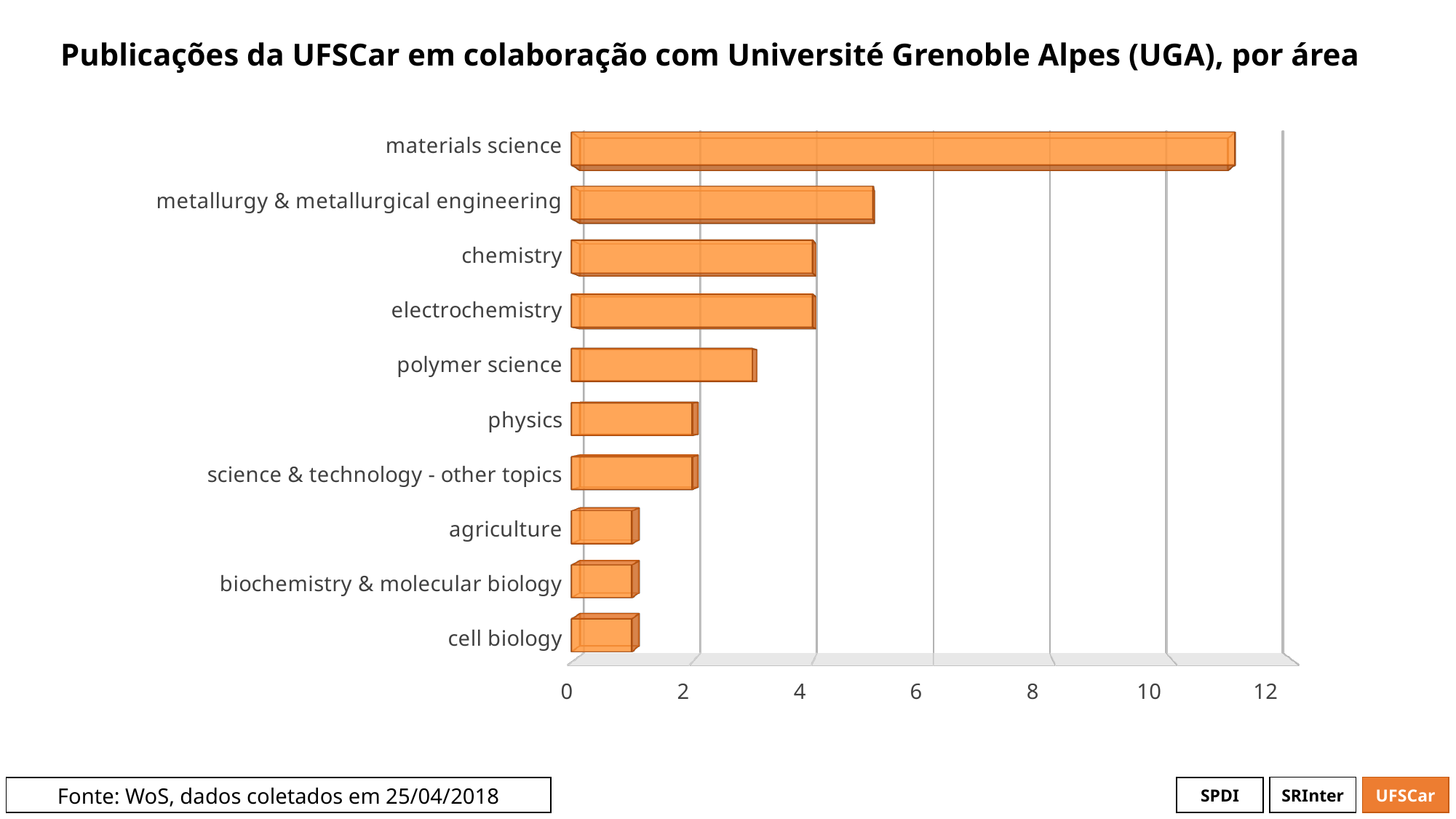
Is the value for metallurgy & metallurgical engineering greater or less than 6? less Which has more publications, chemistry or cell biology? chemistry Which area has the highest number of publications? materials science Which has more publications, materials science or metallurgy & metallurgical engineering? materials science Is the value for materials science greater or less than 10? greater What is the title of the chart? Publicações da UFSCar em colaboração com Université Grenoble Alpes (UGA), por área Is the value for metallurgy & metallurgical engineering greater or less than 4? greater Which has more publications, polymer science or physics? polymer science What kind of chart is shown on the slide? bar chart How many areas (categories) are shown in the chart? 10